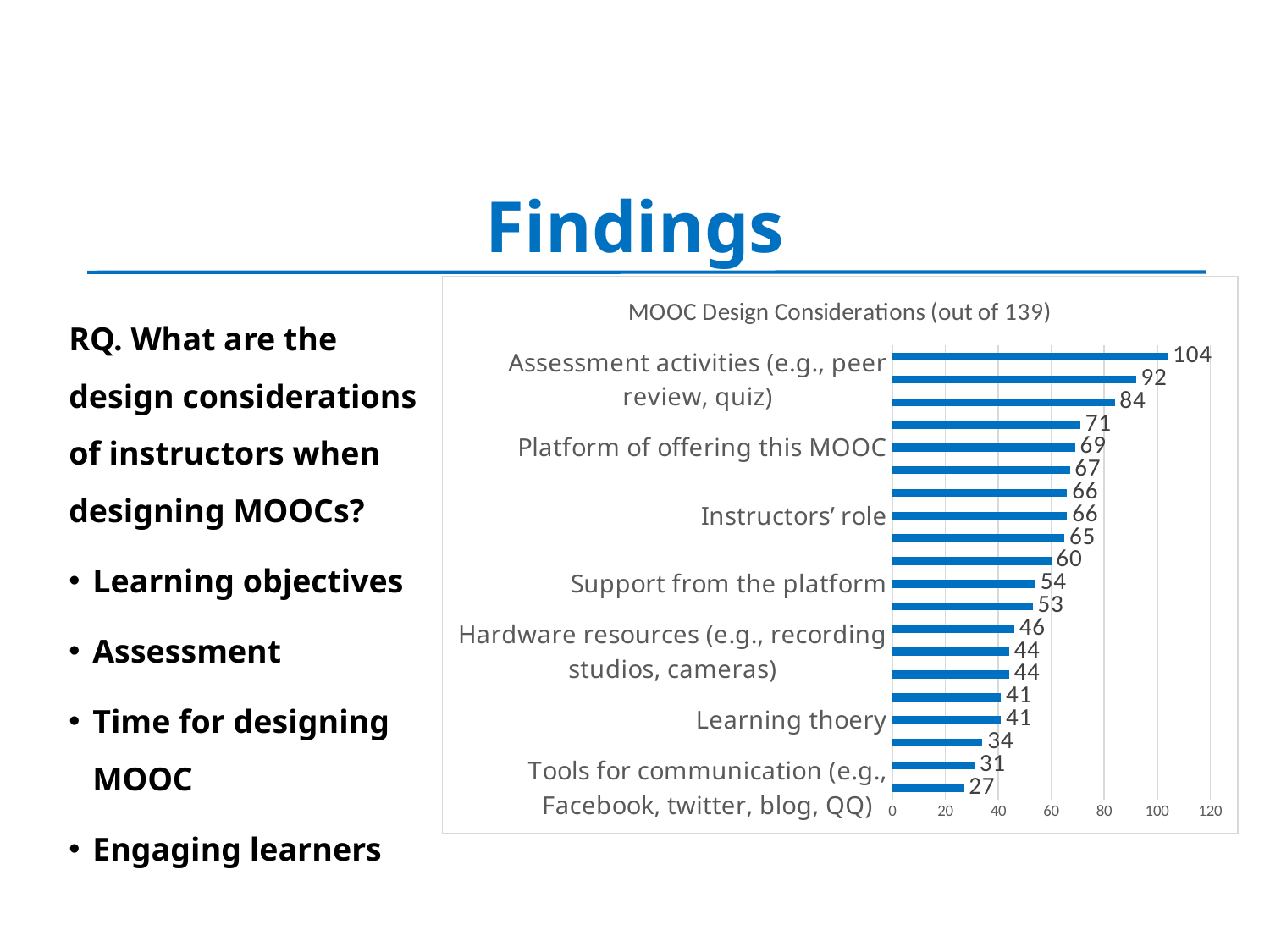
What is the difference between the highest and lowest values in the chart? 77 What is the highest value shown in the chart? 104 What kind of chart is shown on the slide? bar chart How many bars are plotted in the chart? 20 What is the value for Instructors' role? 66 What is the value for Learning thoery? 41 What is the maximum value shown on the horizontal axis? 120 What is the lowest value shown in the chart? 27 What is the value for Hardware resources (e.g., recording studios, cameras)? 44 Which has a larger value, Instructors' role or Learning thoery? Instructors' role What is the value for Platform of offering this MOOC? 69 What is the title of the chart? MOOC Design Considerations (out of 139)